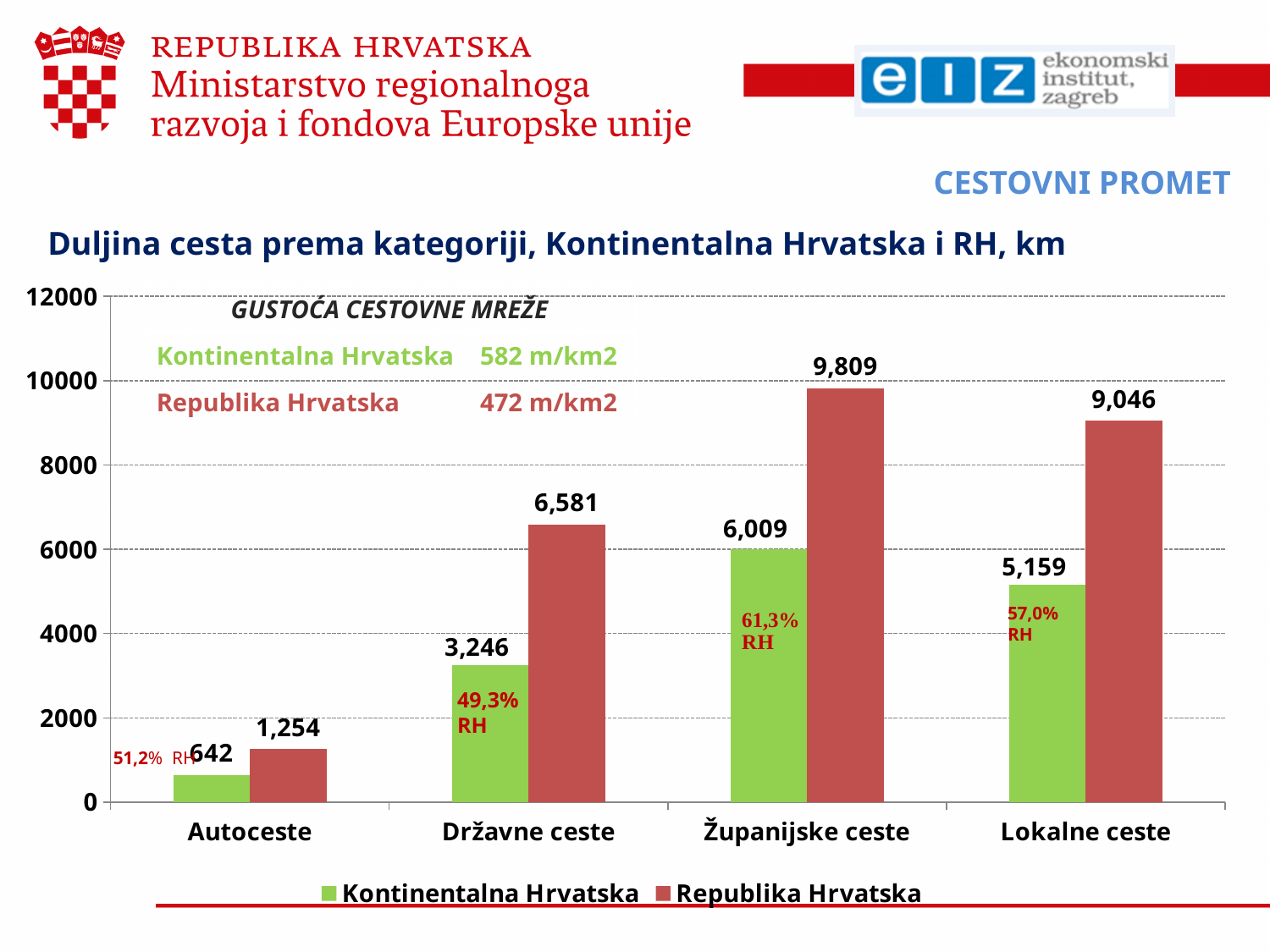
What is the value for Republika Hrvatska in the Autoceste category? 1,254 What kind of chart is shown on the slide? bar chart Which is larger: the Kontinentalna Hrvatska value for Županijske ceste or the Republika Hrvatska value for Državne ceste? Republika Hrvatska value for Državne ceste What is the value for Republika Hrvatska in the Županijske ceste category? 9,809 What is the value for Kontinentalna Hrvatska in the Državne ceste category? 3,246 Is the Republika Hrvatska value for Lokalne ceste greater or less than 8000? greater Which category has the highest value for Republika Hrvatska? Županijske ceste How many series does the legend list? 2 Which category has the lowest value for Kontinentalna Hrvatska? Autoceste What is the value for Kontinentalna Hrvatska in the Lokalne ceste category? 5,159 What is the difference between the Republika Hrvatska and Kontinentalna Hrvatska values for Lokalne ceste? 3,887 How many categories are shown on the x axis? 4